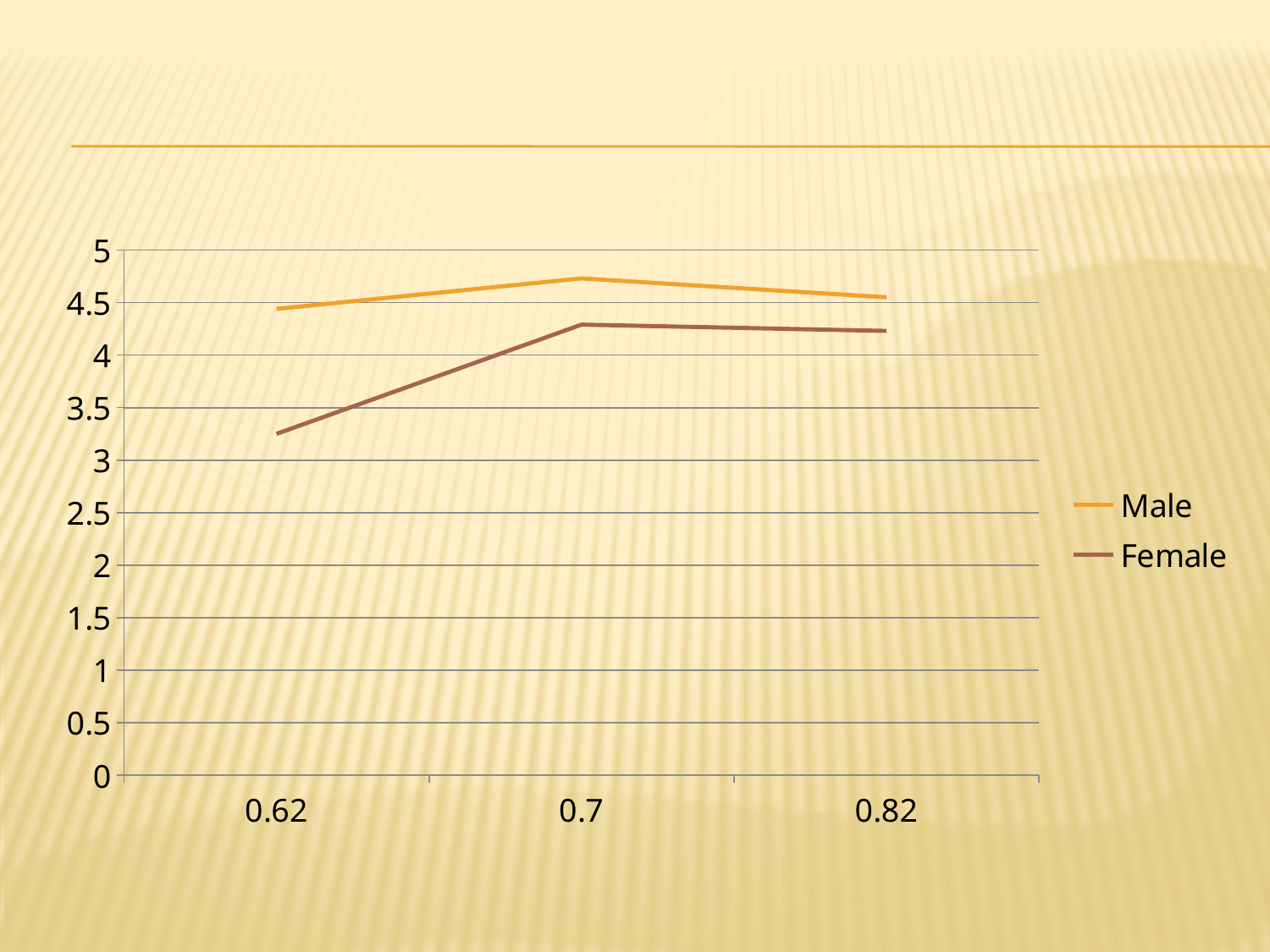
What colour is the Female line? brown At 0.62, which series has the larger value, Male or Female? Male At which x-axis category does the Female series have its lowest value? 0.62 At which x-axis category does the Male series reach its highest value? 0.7 Is the Male value at 0.7 greater or less than 4.5? greater How many series does the legend list? 2 At which x-axis category does the Female series reach its highest value? 0.7 Which series does the legend list first? Male What kind of chart is shown on the slide? line chart Is the Female value at 0.62 greater or less than 3.5? less How many categories are shown on the x axis? 3 Does the Female series rise or fall from 0.62 to 0.7? rise